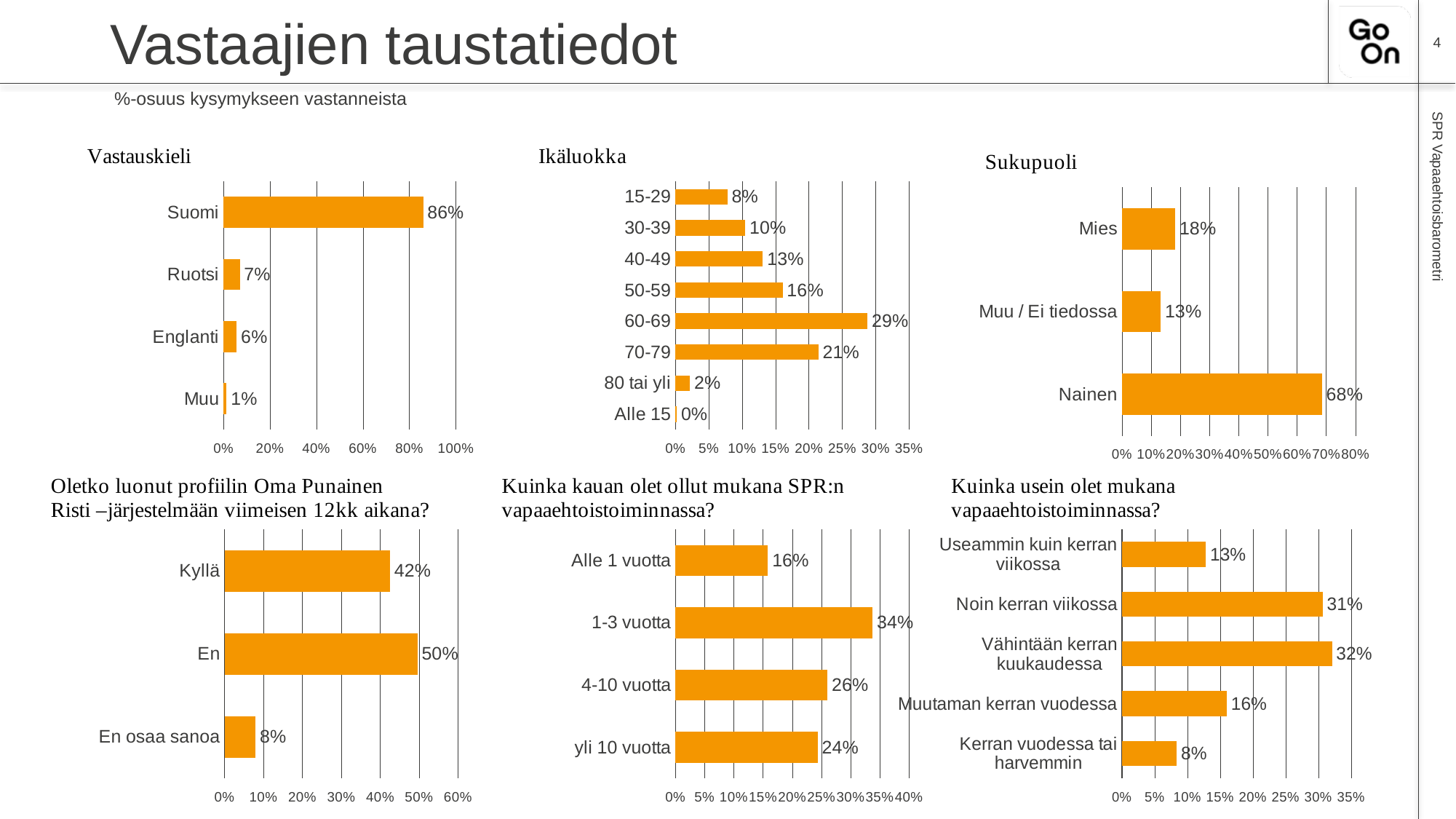
In the chart titled 'Oletko luonut profiilin Oma Punainen Risti –järjestelmään viimeisen 12kk aikana?', which is larger, Kyllä or En? En In the chart titled 'Kuinka kauan olet ollut mukana SPR:n vapaaehtoistoiminnassa?', which category has the lowest value? Alle 1 vuotta In the chart titled 'Kuinka usein olet mukana vapaaehtoistoiminnassa?', what is the value for Noin kerran viikossa? 31% In the Sukupuoli chart, what is the difference between Nainen and Mies? 50% In the Ikäluokka chart, what is the value for 70-79? 21% What type of chart is the Ikäluokka chart? Bar chart In the chart titled 'Kuinka kauan olet ollut mukana SPR:n vapaaehtoistoiminnassa?', what is the value for 4-10 vuotta? 26% In the chart titled 'Oletko luonut profiilin Oma Punainen Risti –järjestelmään viimeisen 12kk aikana?', what is the value for En osaa sanoa? 8% In the Sukupuoli chart, how many categories are shown? 3 In the chart titled 'Kuinka usein olet mukana vapaaehtoistoiminnassa?', how many categories are shown? 5 In the Vastauskieli chart, what is the value for Suomi? 86% In the Ikäluokka chart, which age group has the highest value? 60-69